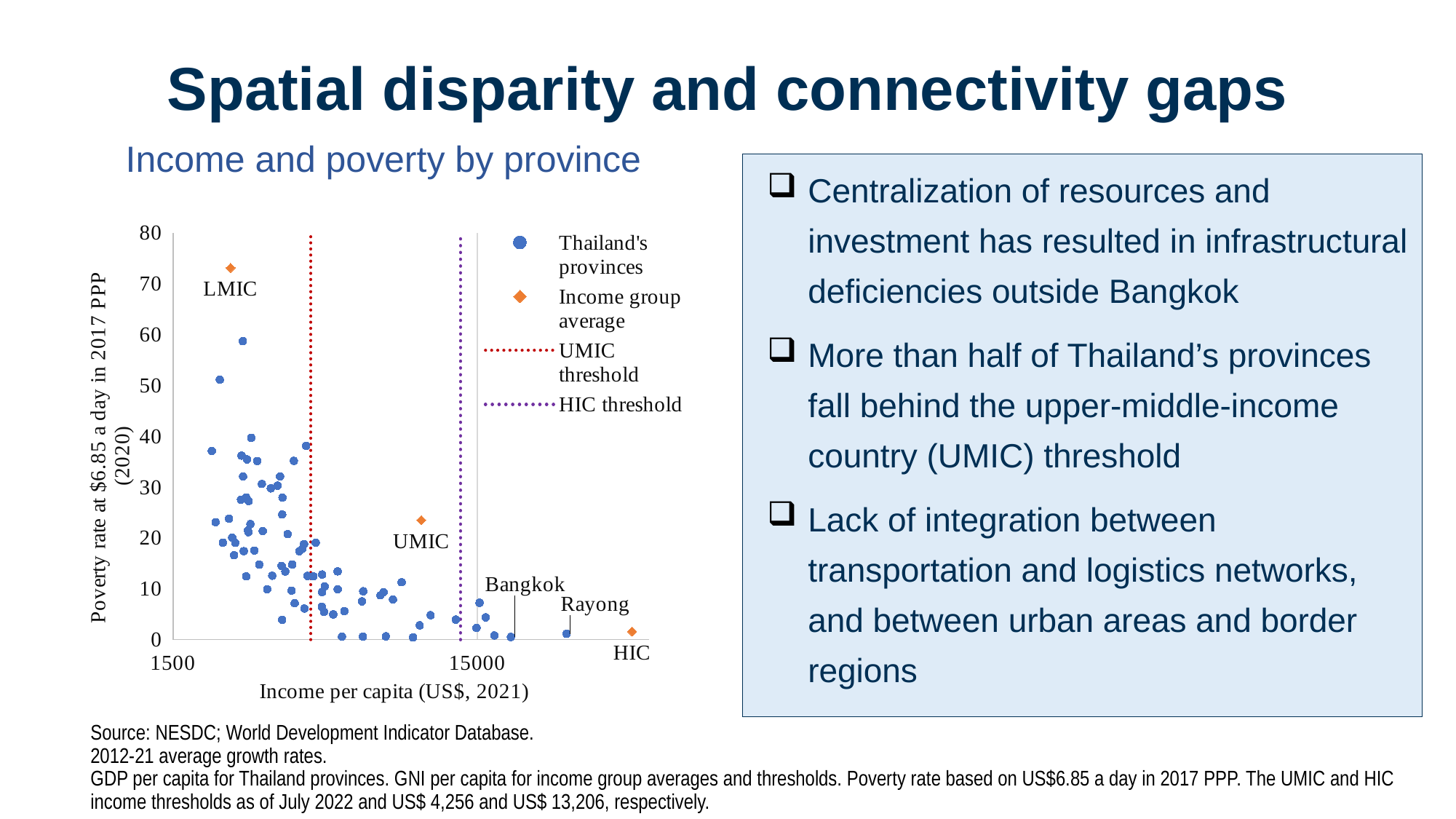
In the "Income and poverty by province" chart, is the poverty rate for the UMIC income group average greater or less than 20? greater In the "Income and poverty by province" chart, does the poverty rate of provinces generally rise or fall as income per capita increases? fall In the "Income and poverty by province" chart, which has a higher poverty rate: the LMIC average or the UMIC average? LMIC In the "Income and poverty by province" chart, is the poverty rate for Bangkok greater or less than 10? less How many entries does the legend of the "Income and poverty by province" chart list? 4 In the "Income and poverty by province" chart, is the poverty rate for the LMIC income group average greater or less than 70? greater What kind of chart is shown under the heading "Income and poverty by province"? scatter chart In the "Income and poverty by province" chart, what colour is the dotted line marking the UMIC threshold? red What is the label of the x axis in the "Income and poverty by province" chart? Income per capita (US$, 2021) In the "Income and poverty by province" chart, which income group average has the highest poverty rate? LMIC In the "Income and poverty by province" chart, which income group average has the lowest poverty rate? HIC